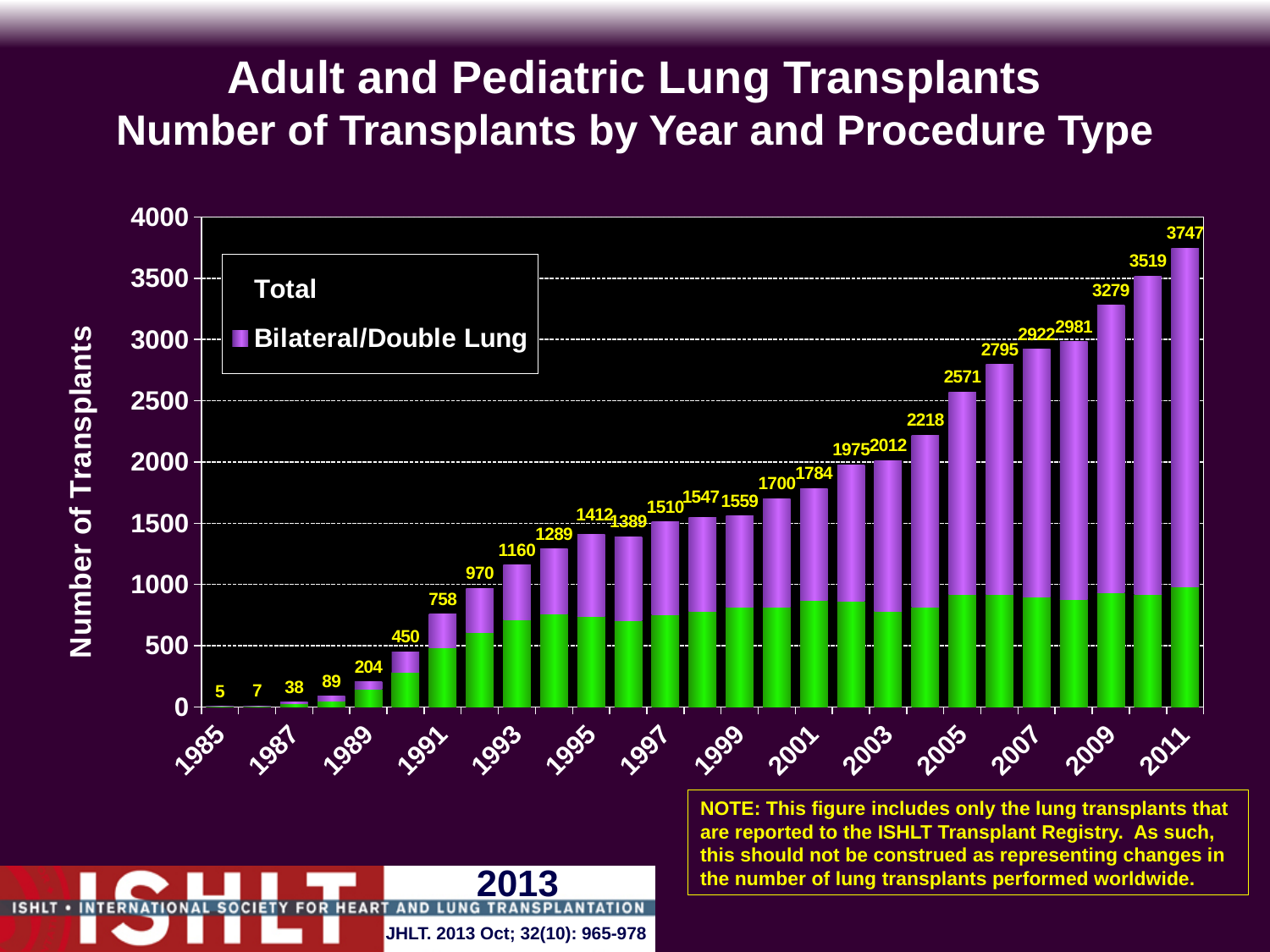
Which year has a larger total number of transplants, 1995 or 1996? 1995 What is the difference between the total number of transplants in 2011 and in 2010? 228 Do the total number of transplants generally rise or fall from 1985 to 2011? Rise Which year has the lowest total number of transplants? 1985 Which year has the highest total number of transplants? 2011 What kind of chart is shown on the slide? Stacked bar chart What is the total number of transplants shown for 2005? 2571 What is the total number of transplants shown for 1991? 758 How many years are shown on the x axis of the chart? 27 What is the total number of transplants shown for 2011? 3747 Is the Bilateral/Double Lung value for 2011 greater or less than 2500? greater What is the label on the y axis of the chart? Number of Transplants